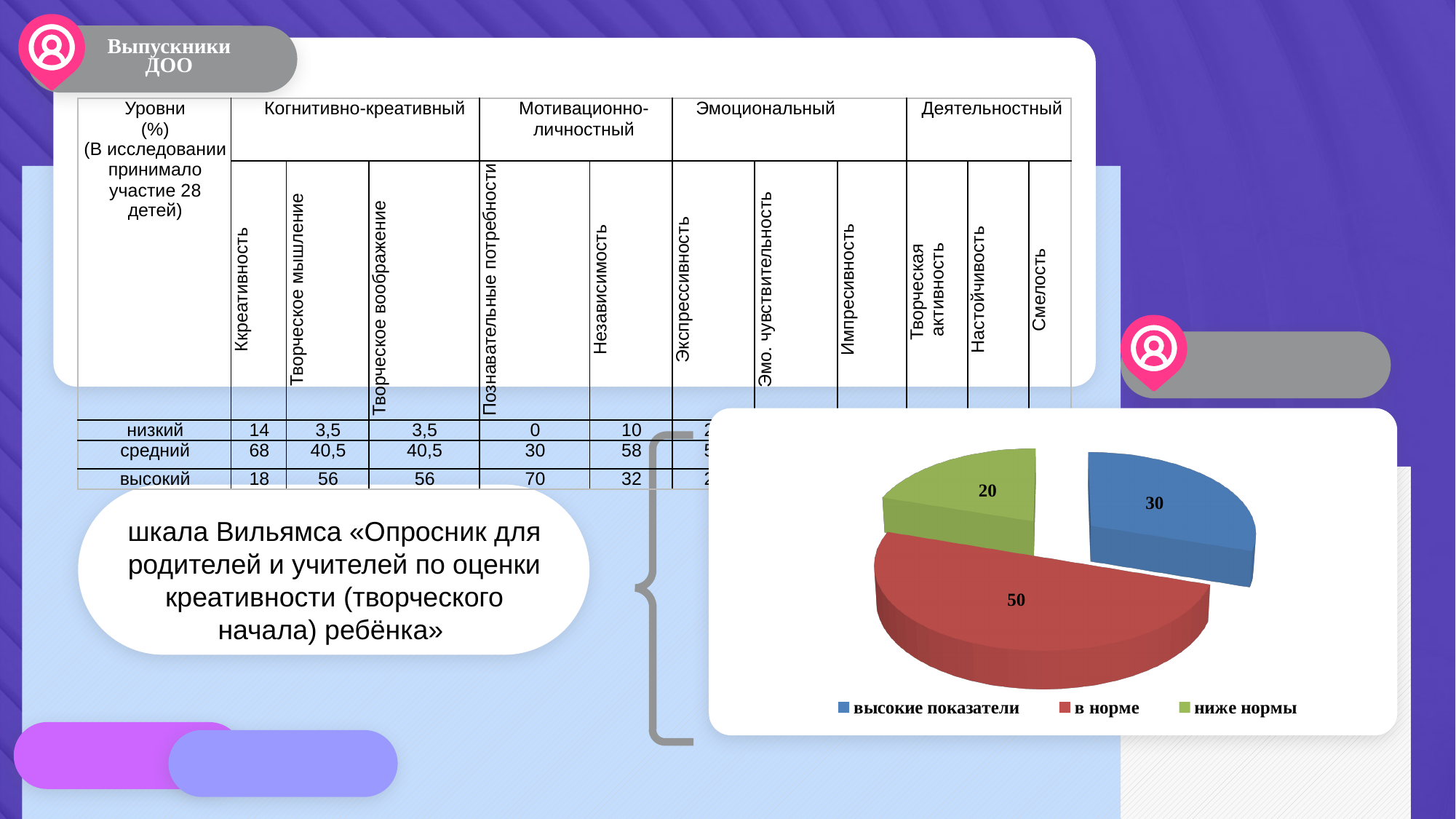
What is the value of the "ниже нормы" slice in the pie chart? 20 What is the value of the "высокие показатели" slice in the pie chart? 30 Which category has the largest slice in the pie chart? в норме What kind of chart is shown on the slide? pie chart How many entries does the pie chart legend list? 3 What is the value of the "в норме" slice in the pie chart? 50 What colour is the "в норме" slice in the pie chart? red What is the difference between the "в норме" and "ниже нормы" values in the pie chart? 30 How many slices does the pie chart have? 3 What is the difference between the "высокие показатели" and "ниже нормы" values in the pie chart? 10 Which category has the smallest slice in the pie chart? ниже нормы Which is larger in the pie chart: "высокие показатели" or "ниже нормы"? высокие показатели